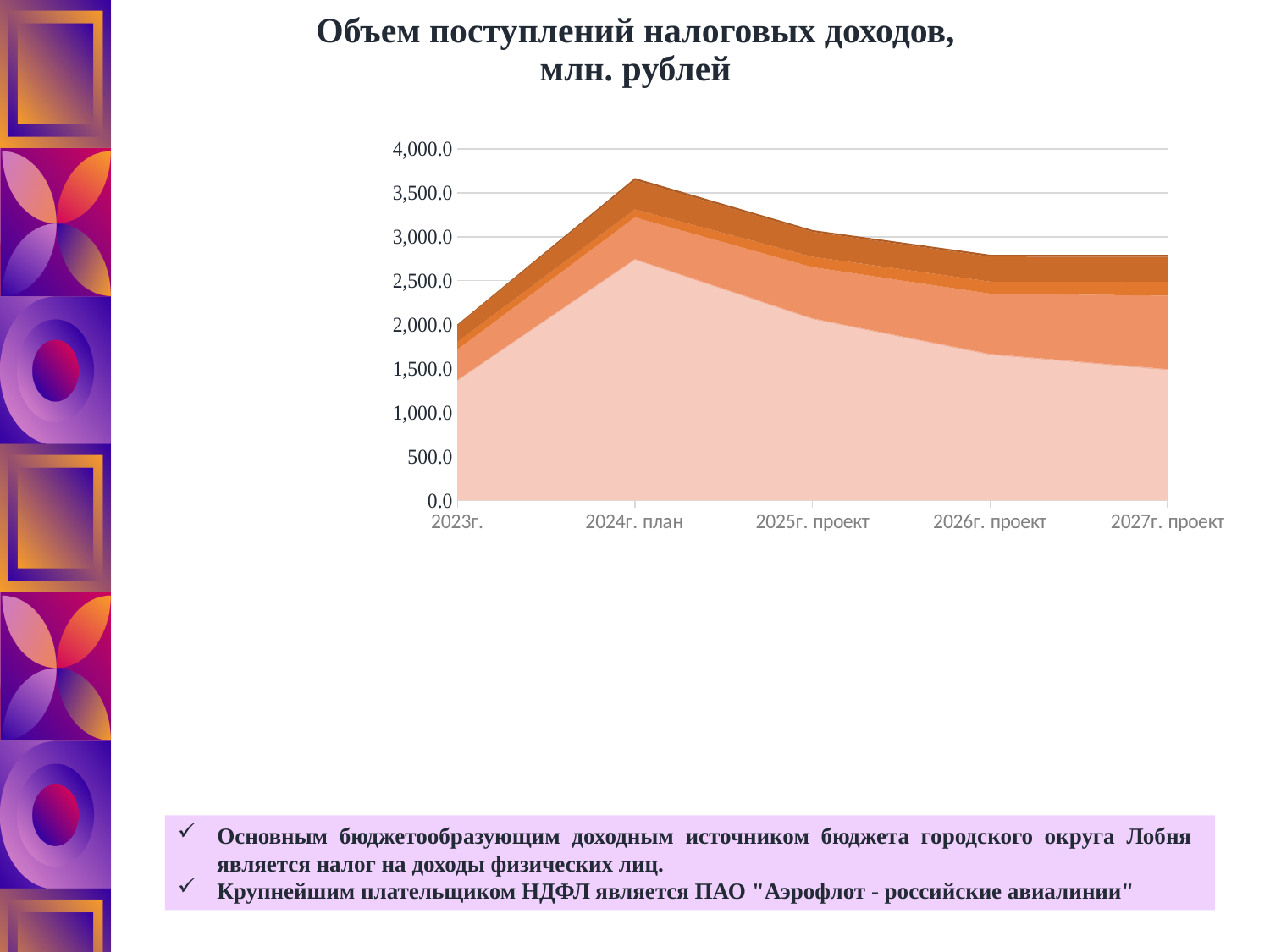
Is the total value for 2027г. проект greater or less than 3,000.0? less How many categories are shown along the x axis of the chart? 5 Is the value of the bottom (lightest) layer for 2027г. проект greater or less than 2,000.0? less Is the total value for 2023г. greater or less than 2,500.0? less Which has the larger total value, 2024г. план or 2025г. проект? 2024г. план What is the title of the chart? Объем поступлений налоговых доходов, млн. рублей Do the total values rise or fall from 2024г. план to 2027г. проект? fall Which category has the highest total value in the chart? 2024г. план Which category has the lowest total value in the chart? 2023г. What kind of chart is shown on the slide? area chart